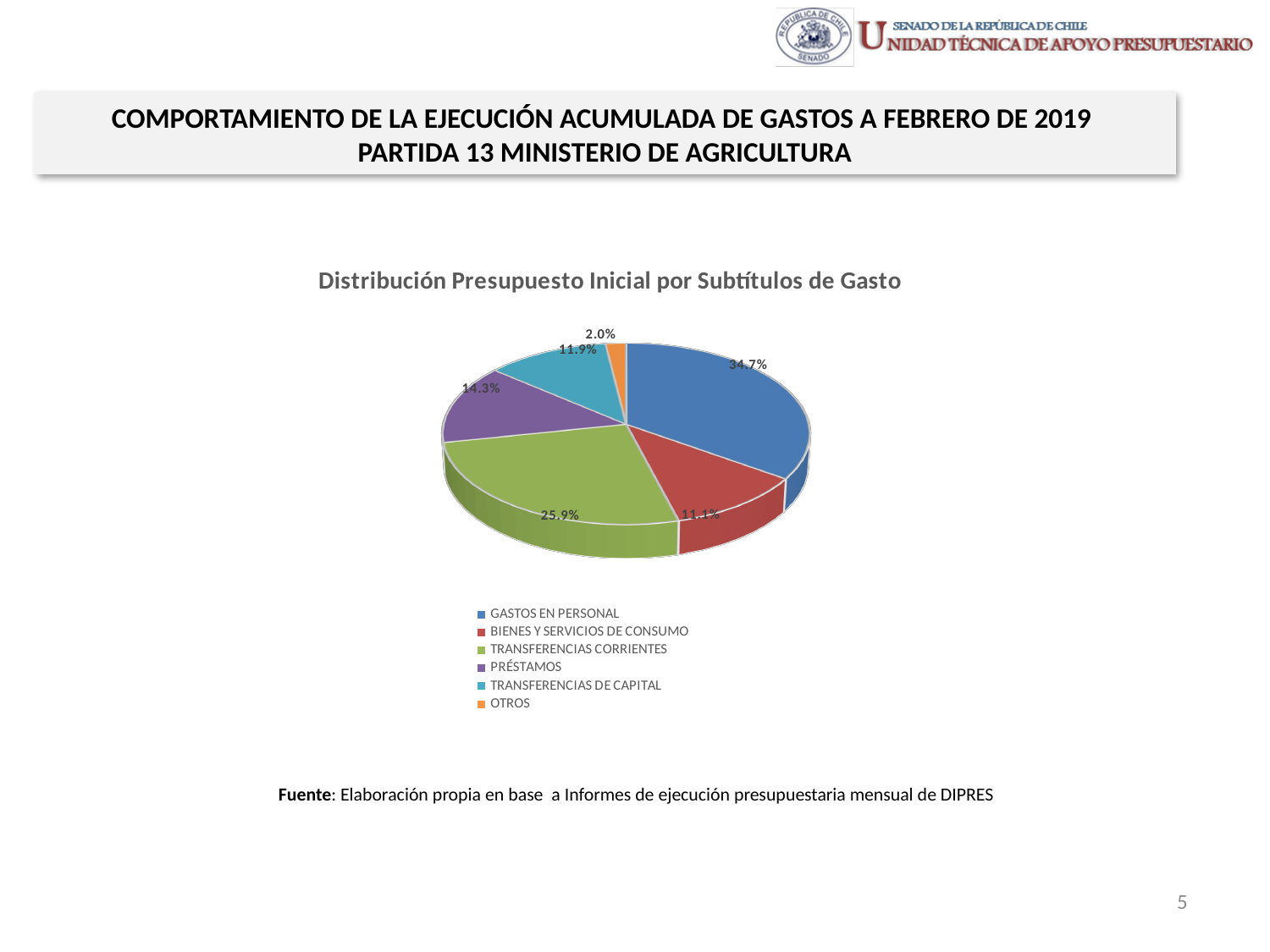
Which category has the largest share of the pie? GASTOS EN PERSONAL What share of the pie does TRANSFERENCIAS CORRIENTES represent? 25.9% How many categories does the pie chart have? 6 What is the value shown for BIENES Y SERVICIOS DE CONSUMO? 11.1% What kind of chart is shown on the slide? pie chart Which is larger, the share for PRÉSTAMOS or the share for TRANSFERENCIAS DE CAPITAL? PRÉSTAMOS Which category has the smallest share of the pie? OTROS What is the value shown for OTROS? 2.0% What is the difference in percentage points between GASTOS EN PERSONAL and TRANSFERENCIAS CORRIENTES? 8.8 What is the value shown for PRÉSTAMOS? 14.3% What is the title of the chart? Distribución Presupuesto Inicial por Subtítulos de Gasto What share of the pie does GASTOS EN PERSONAL represent? 34.7%